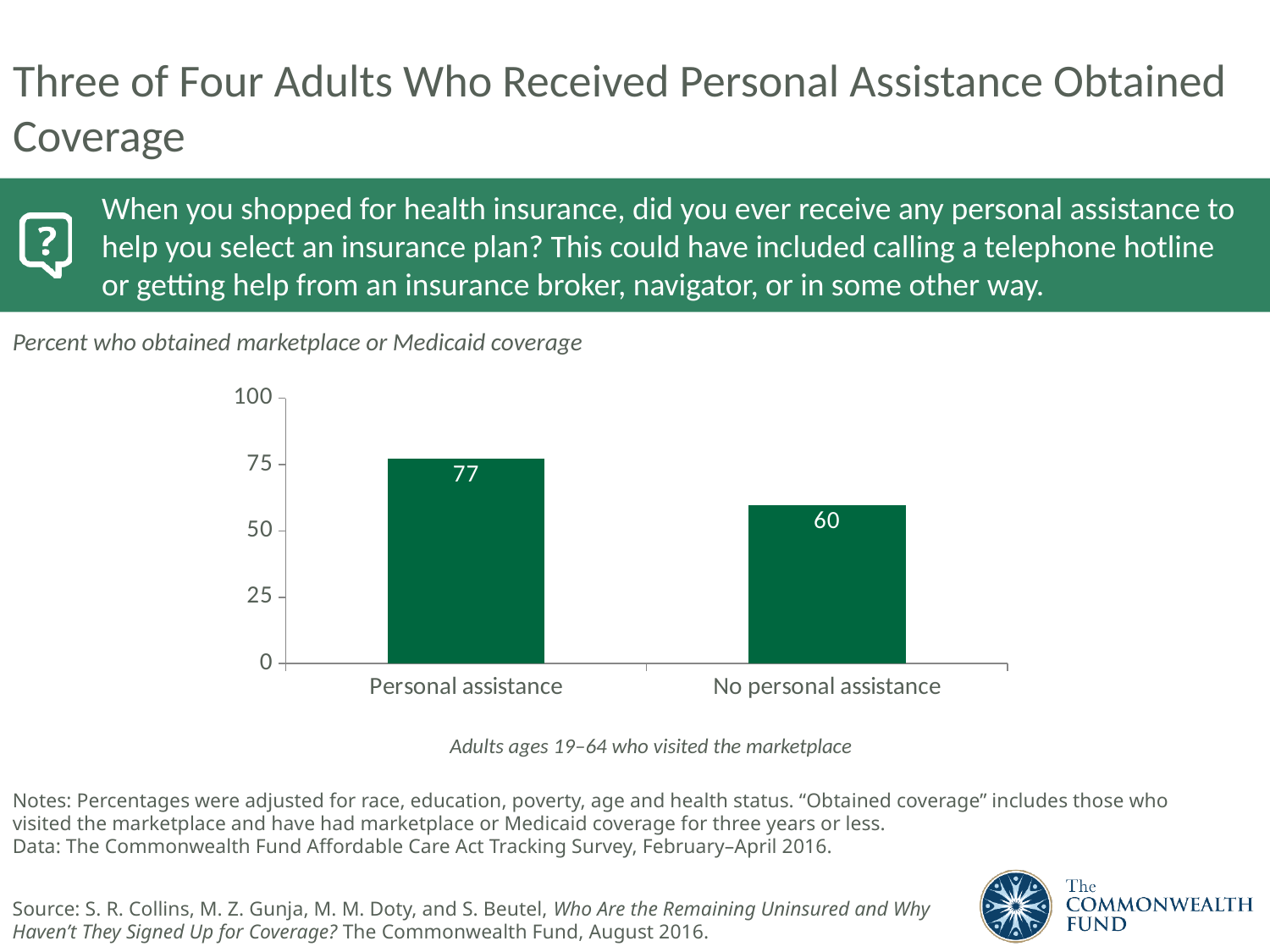
Which category has the lowest value? No personal assistance What is the difference between the values for Personal assistance and No personal assistance? 17 Which category has the highest value? Personal assistance What kind of chart is shown on the slide? Bar chart What is the subtitle printed above the chart describing what is plotted? Percent who obtained marketplace or Medicaid coverage How many categories are shown on the x axis? 2 Is the value for No personal assistance greater or less than 75? less What is the value for Personal assistance? 77 Is the value for Personal assistance greater or less than 75? greater Which is larger, the value for Personal assistance or the value for No personal assistance? Personal assistance What is the value for No personal assistance? 60 What is the maximum value shown on the y axis? 100